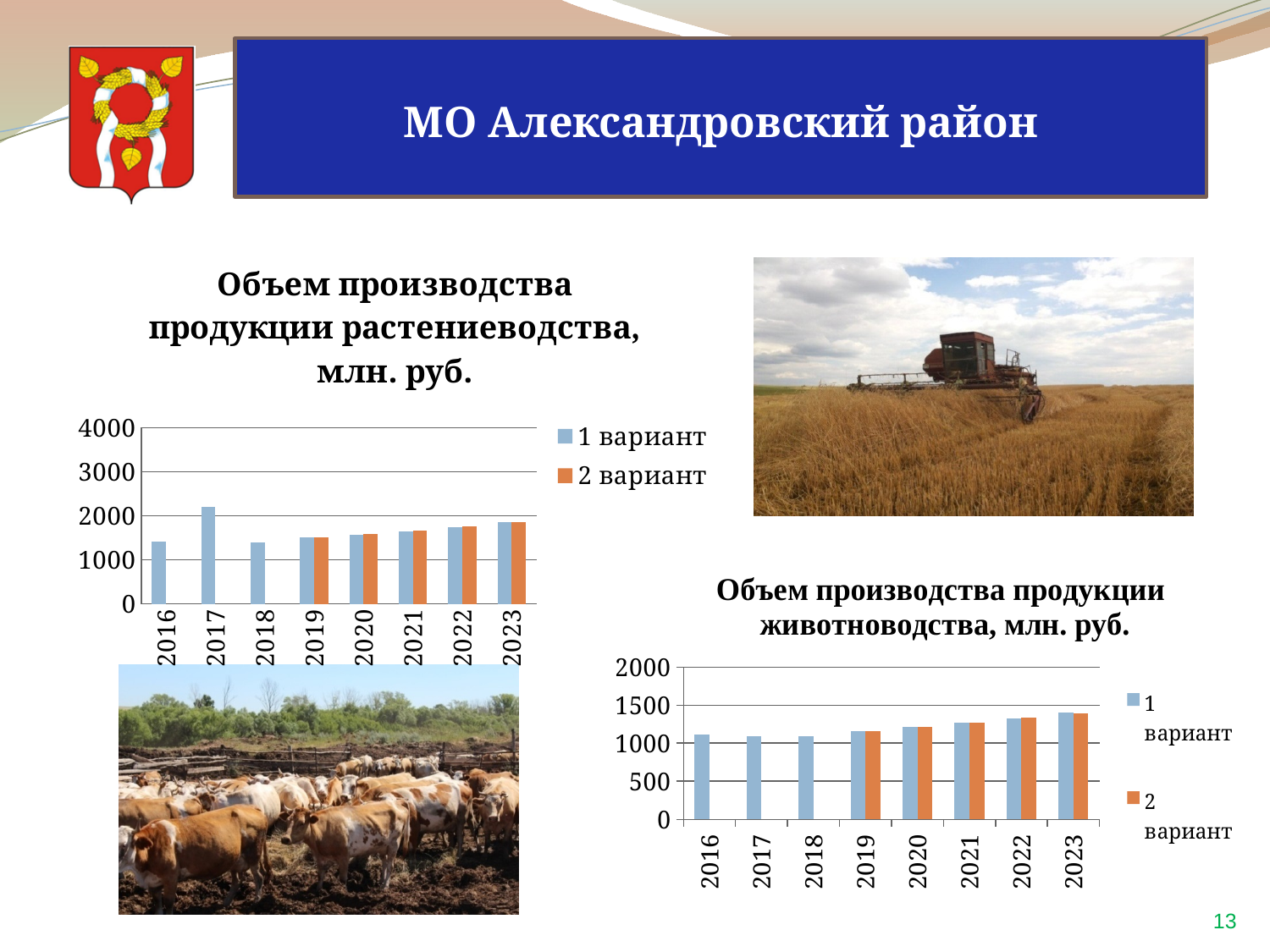
In the chart titled "Объем производства продукции животноводства, млн. руб.", which year has the highest value for "1 вариант"? 2023 How many years are shown on the x axis of the chart titled "Объем производства продукции растениеводства, млн. руб."? 8 In the chart titled "Объем производства продукции животноводства, млн. руб.", is the value for "2 вариант" in 2023 greater or less than 1500? less In the chart titled "Объем производства продукции животноводства, млн. руб.", do the values for "1 вариант" rise or fall from 2019 to 2023? rise In the chart titled "Объем производства продукции растениеводства, млн. руб.", is the value for "1 вариант" in 2016 greater or less than 2000? less In the chart titled "Объем производства продукции растениеводства, млн. руб.", which is larger for "1 вариант": 2017 or 2018? 2017 How many series does the legend list in the chart titled "Объем производства продукции животноводства, млн. руб."? 2 In the chart titled "Объем производства продукции растениеводства, млн. руб.", is the value for "1 вариант" in 2017 greater or less than 2000? greater In the chart titled "Объем производства продукции растениеводства, млн. руб.", which year has the highest value for "1 вариант"? 2017 In the chart titled "Объем производства продукции растениеводства, млн. руб.", what colour are the bars for "2 вариант"? orange What kind of chart is the chart titled "Объем производства продукции растениеводства, млн. руб."? bar chart